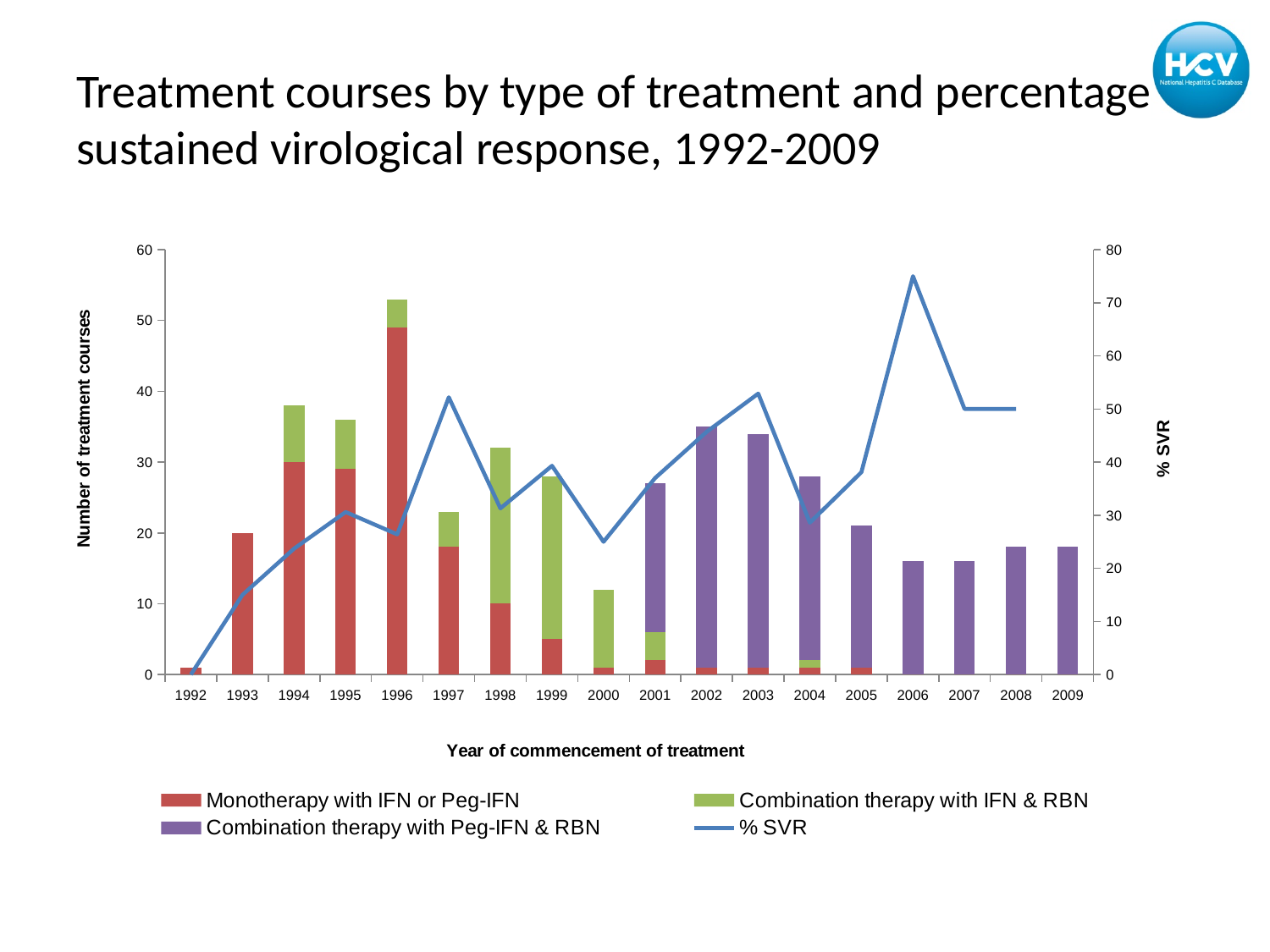
Which year has more total treatment courses, 2003 or 2004? 2003 Which year has the highest total number of treatment courses? 1996 How many series does the legend list? 4 Does the % SVR line rise or fall from 2006 to 2007? fall Which year has the lowest total number of treatment courses? 1992 In which year does the % SVR line reach its highest point? 2006 What is the label of the left vertical axis? Number of treatment courses Is the number of treatment courses in 2008 greater or less than 20? less Is the total number of treatment courses in 1996 greater or less than 50? greater How many years are shown along the x axis? 18 What kind of chart is shown on the slide? A bar chart (stacked bars) combined with a line Is the % SVR value for 2006 greater or less than 70? greater